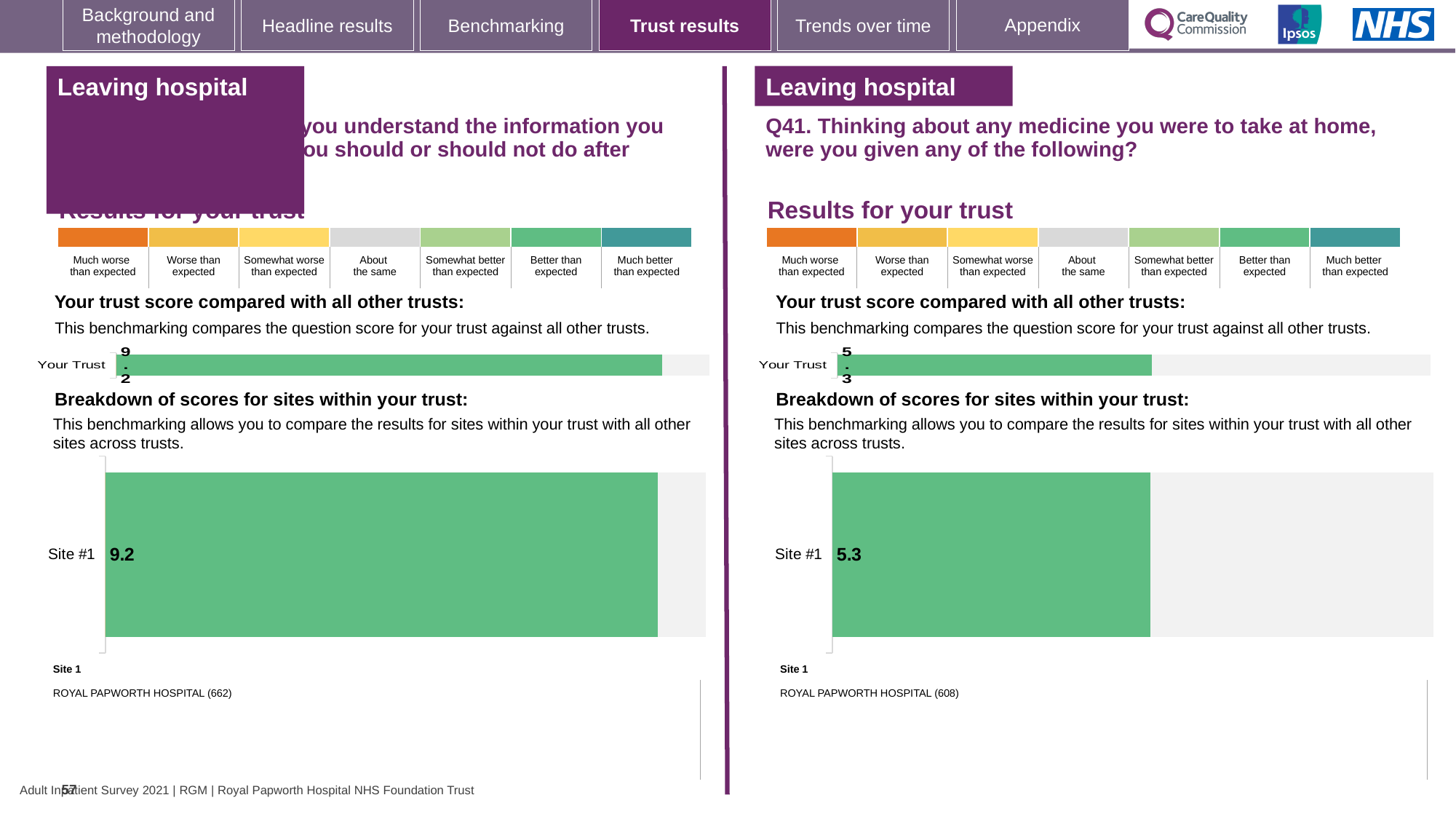
What kind of chart is used to show the Site #1 score on the left panel? Bar chart How many sites are shown in the 'Breakdown of scores for sites within your trust' chart on the right panel (Q41)? 1 On the left panel, what is the score for Site #1 in the 'Breakdown of scores for sites within your trust' chart? 9.2 On the right panel (Q41), what is the score shown for Your Trust in the 'Your trust score compared with all other trusts' chart? 5.3 On the left panel, what is the score shown for Your Trust in the 'Your trust score compared with all other trusts' chart? 9.2 Which hospital is listed as Site 1 on the right panel (Q41)? ROYAL PAPWORTH HOSPITAL (608) What is the difference between the Site #1 score on the left panel (9.2) and the Site #1 score on the right panel (5.3)? 3.9 What colour is the Your Trust bar on the right panel (Q41)? Green How many rating categories does the colour key above the 'Your trust score' chart on the left panel list? 7 On the right panel (Q41), what is the score for Site #1 in the 'Breakdown of scores for sites within your trust' chart? 5.3 Which is larger: the Your Trust score on the left panel or the Your Trust score on the right panel (Q41)? Left panel (9.2)